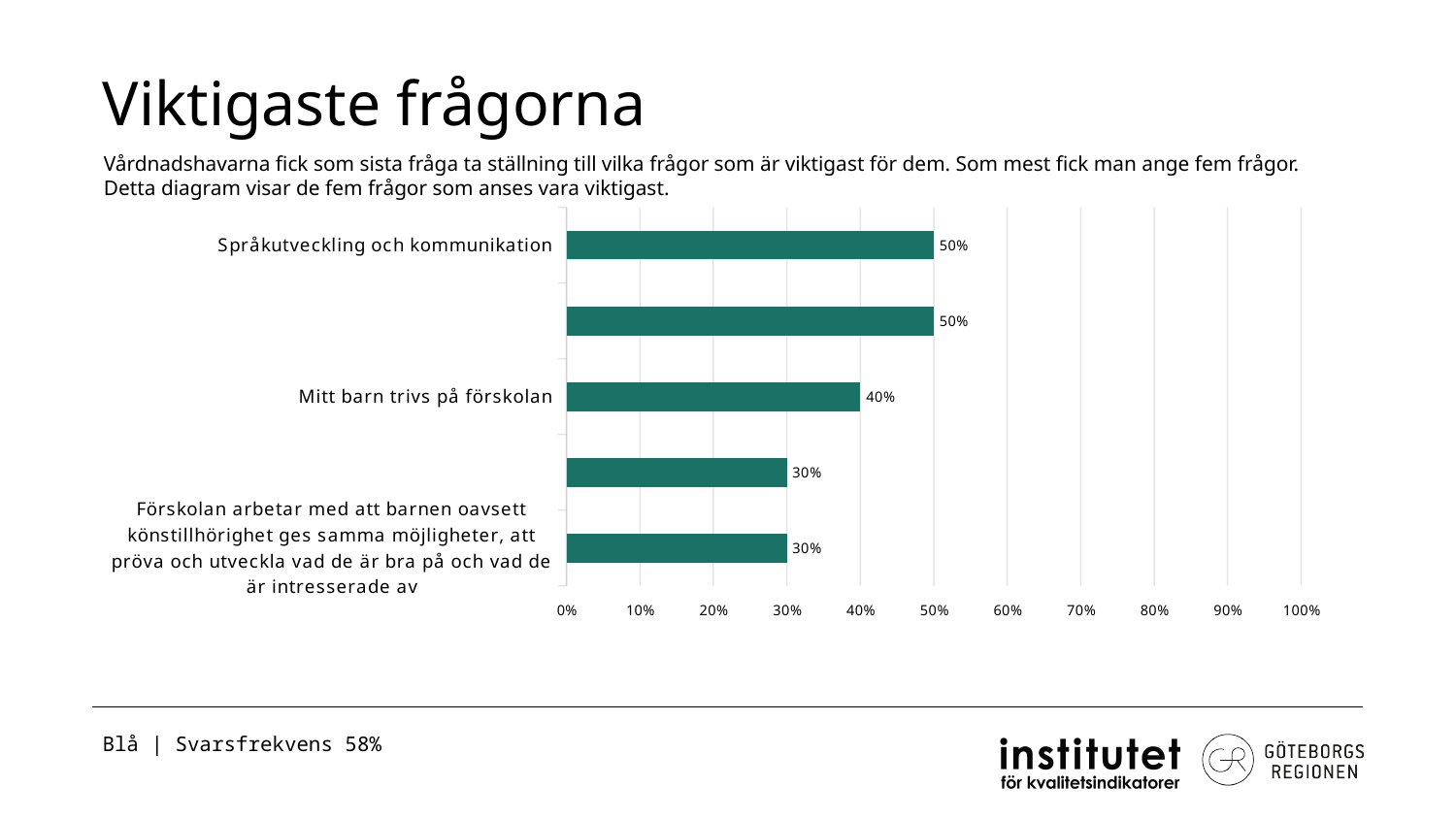
What is the value for "Förskolan arbetar med att barnen oavsett könstillhörighet ges samma möjligheter, att pröva och utveckla vad de är bra på och vad de är intresserade av"? 30% Is the value for "Mitt barn trivs på förskolan" greater or less than 60%? less How many bars are plotted in the chart? 5 What is the maximum value shown on the horizontal axis of the chart? 100% What kind of chart is shown on the slide? bar chart What is the lowest value shown in the chart? 30% What is the value for "Mitt barn trivs på förskolan"? 40% What is the value for "Språkutveckling och kommunikation"? 50% What is the difference between the values for "Språkutveckling och kommunikation" and "Mitt barn trivs på förskolan"? 10 percentage points What is the title of the slide containing the chart? Viktigaste frågorna Which has a larger value: "Mitt barn trivs på förskolan" or "Förskolan arbetar med att barnen oavsett könstillhörighet ges samma möjligheter..."? Mitt barn trivs på förskolan What is the highest value shown in the chart? 50%